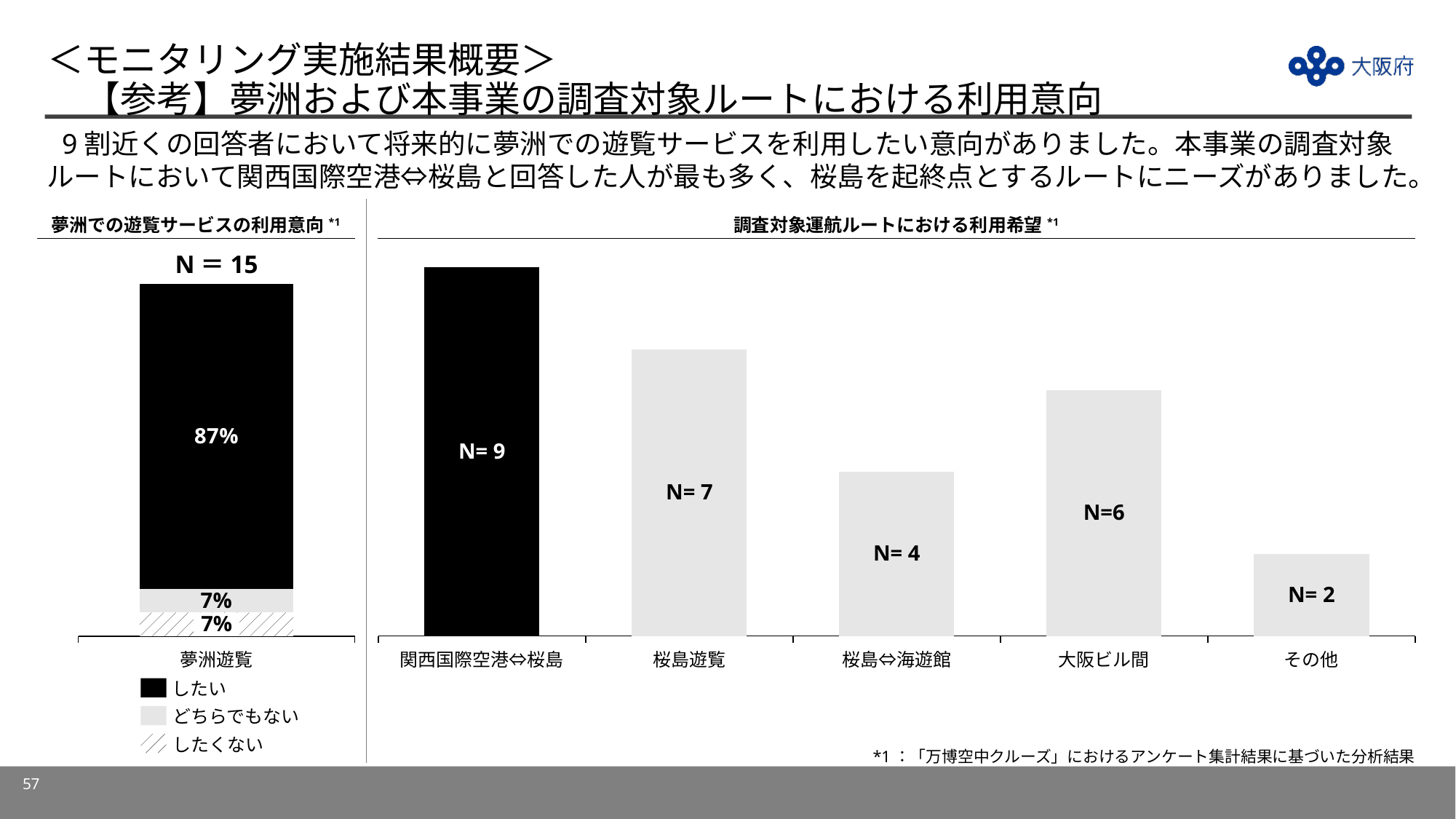
What kind of chart is the chart titled 調査対象運航ルートにおける利用希望? Bar chart In the chart titled 調査対象運航ルートにおける利用希望, which route has the highest value? 関西国際空港⇔桜島 How many series does the legend list in the chart titled 夢洲での遊覧サービスの利用意向? 3 In the chart titled 夢洲での遊覧サービスの利用意向, what percentage of respondents answered したい? 87% In the chart titled 調査対象運航ルートにおける利用希望, which category has the lowest value? その他 In the chart titled 夢洲での遊覧サービスの利用意向, what percentage of respondents answered したくない? 7% In the chart titled 調査対象運航ルートにおける利用希望, which is larger, the value for 大阪ビル間 or the value for 桜島⇔海遊館? 大阪ビル間 In the chart titled 調査対象運航ルートにおける利用希望, what is the value for 関西国際空港⇔桜島? N= 9 In the chart titled 夢洲での遊覧サービスの利用意向, what is the N value shown above the bar? N = 15 How many categories are shown in the chart titled 調査対象運航ルートにおける利用希望? 5 In the chart titled 調査対象運航ルートにおける利用希望, what is the value for 桜島⇔海遊館? N= 4 In the chart titled 調査対象運航ルートにおける利用希望, what is the difference between the values for 桜島遊覧 and 大阪ビル間? 1